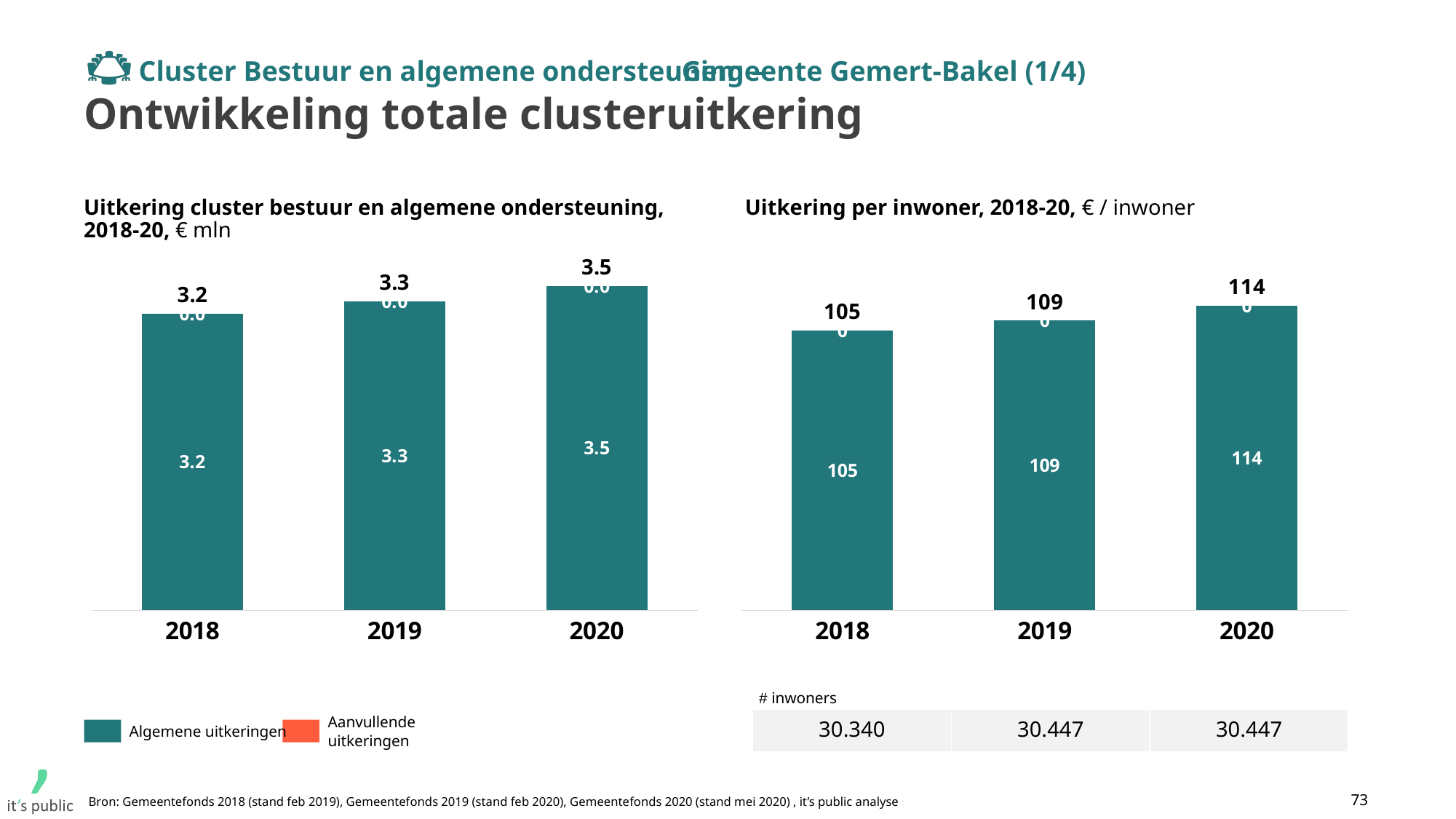
In the right chart (Uitkering per inwoner), what is the value for 2019? 109 In the right chart (Uitkering per inwoner), which year has the highest value? 2020 How many series does the legend below the left chart list? 2 In the right chart (Uitkering per inwoner), what is the difference between the 2020 and 2018 values? 9 In the left chart (Uitkering cluster bestuur en algemene ondersteuning), what is the total value for 2020? 3.5 How many years are shown on the x axis of the left chart (Uitkering cluster bestuur en algemene ondersteuning)? 3 In the left chart (Uitkering cluster bestuur en algemene ondersteuning), what is the difference between the 2020 and 2019 totals? 0.2 In the left chart (Uitkering cluster bestuur en algemene ondersteuning), which year has the lowest total? 2018 In the right chart (Uitkering per inwoner), is the value for 2019 larger or smaller than the value for 2018? larger In the right chart (Uitkering per inwoner), do the values rise or fall from 2018 to 2020? rise In the left chart (Uitkering cluster bestuur en algemene ondersteuning), what is the total value for 2018? 3.2 What kind of chart is the right chart (Uitkering per inwoner)? bar chart